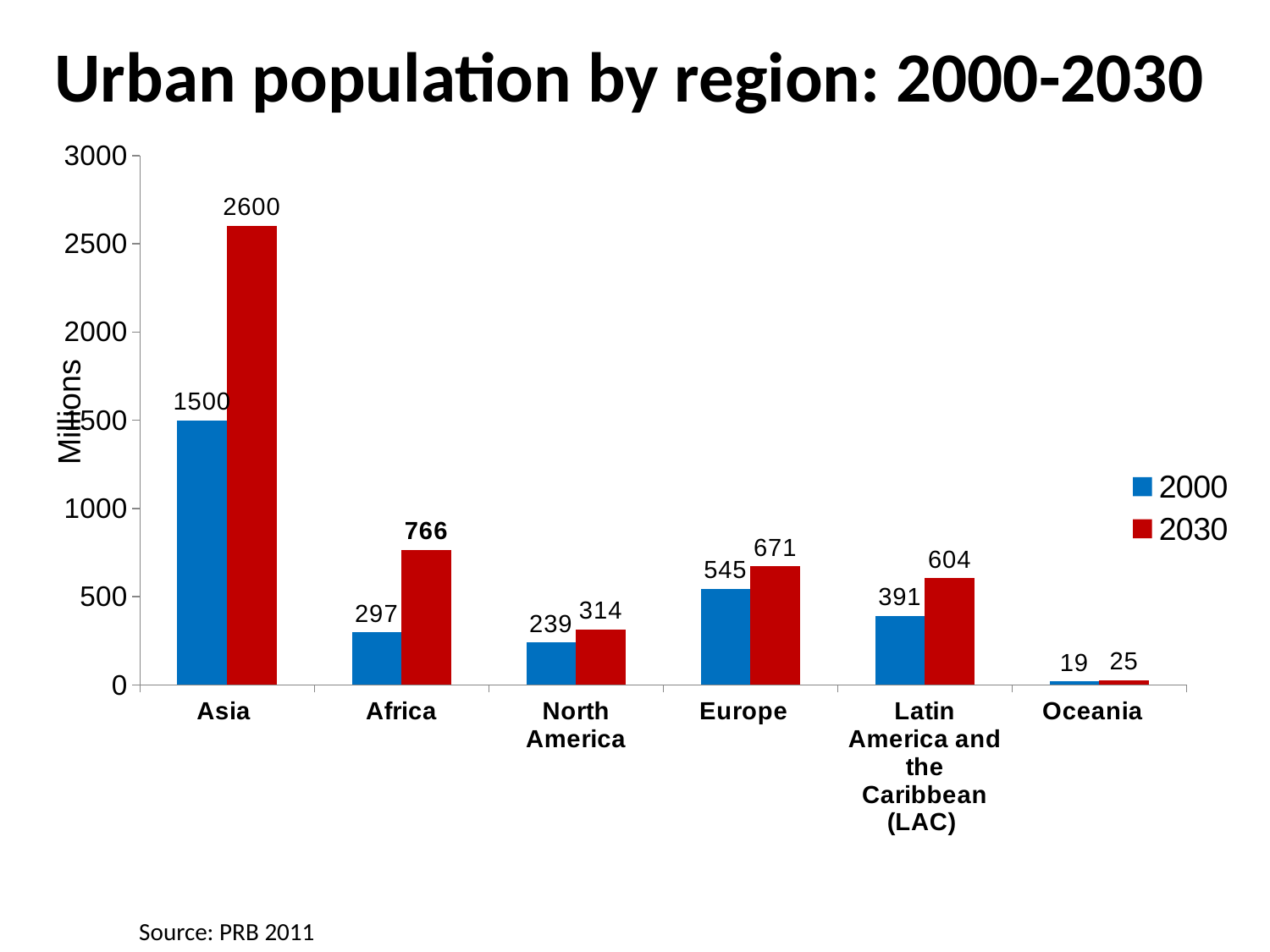
How many regions are shown on the chart? 6 What is the urban population of Africa in 2000? 297 What is the urban population of Asia in 2030? 2600 Which region has the highest urban population in 2030? Asia What is the title of the chart? Urban population by region: 2000-2030 How many series does the legend list? 2 Which region has the lowest urban population in 2000? Oceania What is the difference between Asia's urban population in 2030 and in 2000? 1100 What is the difference between Africa's urban population in 2030 and in 2000? 469 Which is larger: Europe's urban population in 2000 or Latin America and the Caribbean's urban population in 2030? Latin America and the Caribbean in 2030 What kind of chart is shown on the slide? Bar chart What is the urban population of Europe in 2030? 671